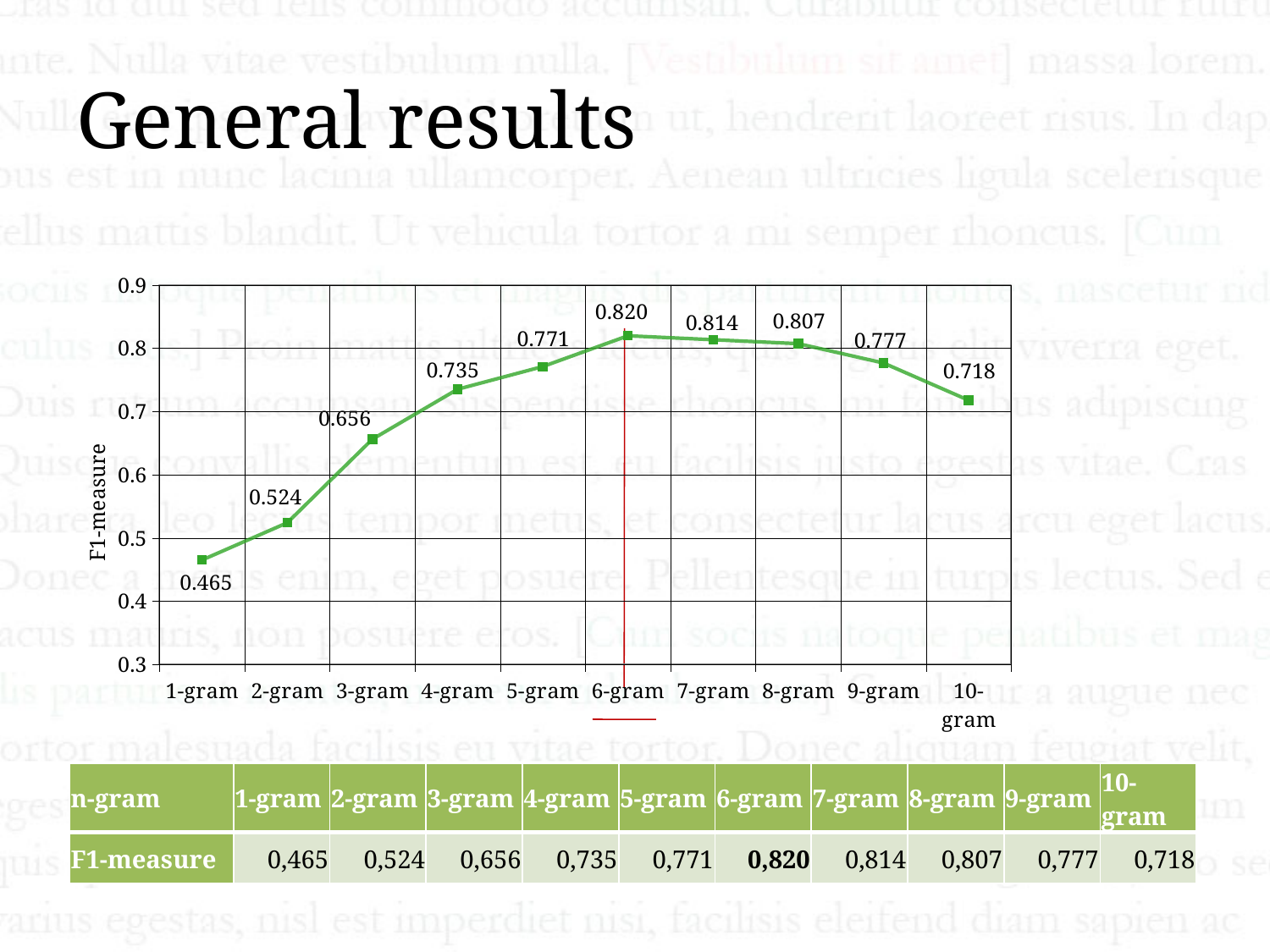
What is the difference in F1-measure between 3-gram and 2-gram? 0.132 Is the F1-measure for 5-gram greater or less than 0.8? less What is the label of the y axis? F1-measure Which n-gram has the lowest F1-measure? 1-gram How many n-gram categories are plotted on the x axis? 10 Which n-gram has the highest F1-measure? 6-gram What is the F1-measure for 1-gram? 0.465 Which has a higher F1-measure, 4-gram or 9-gram? 9-gram What is the F1-measure for 6-gram? 0.820 What is the F1-measure for 10-gram? 0.718 What is the difference in F1-measure between 6-gram and 1-gram? 0.355 What kind of chart is shown on the slide? line chart